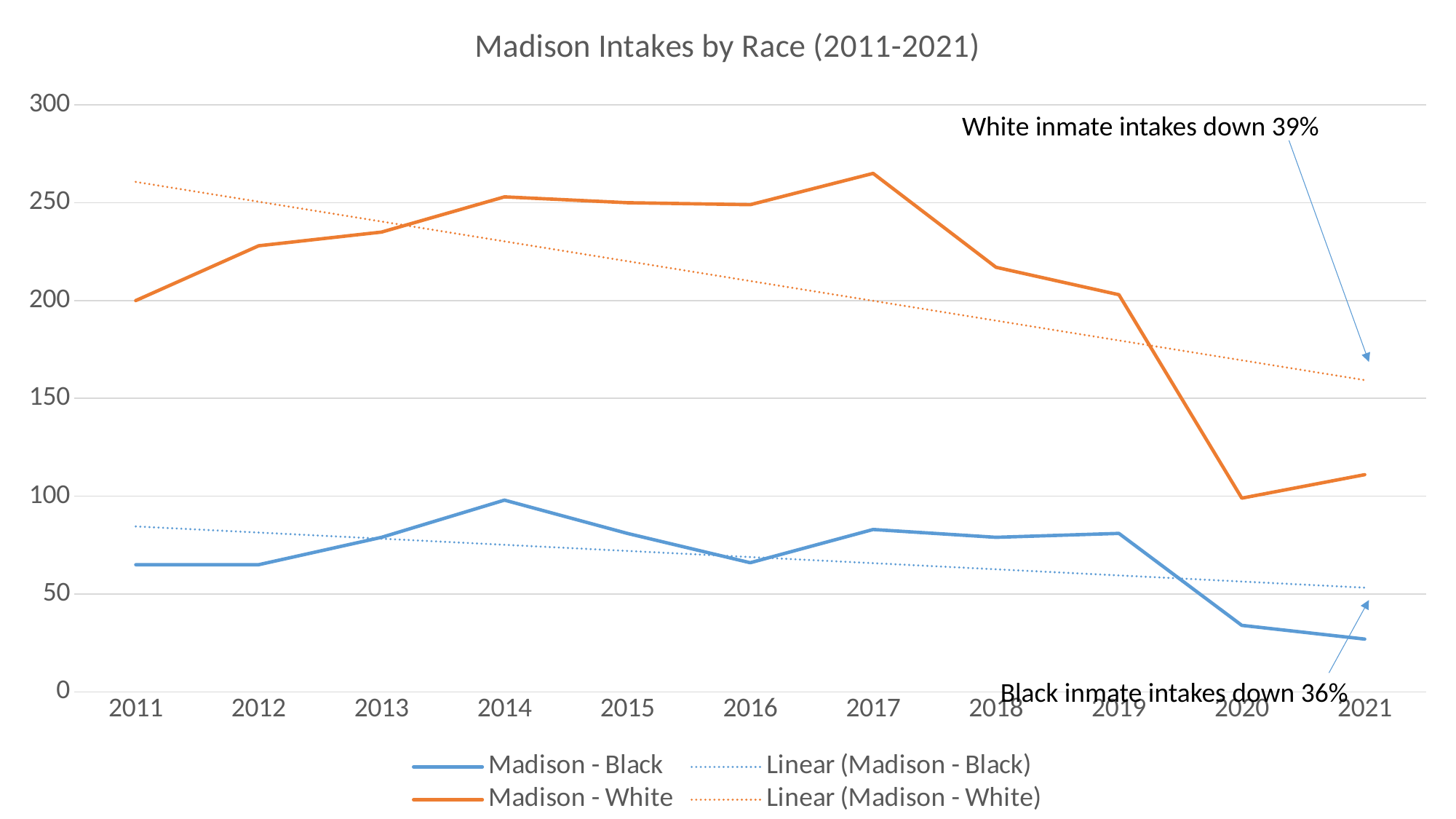
Does the Madison - White series rise or fall from 2017 to 2020? fall In which year is the Madison - White series at its highest? 2017 What kind of chart is shown on the slide? line chart In which year is the Madison - White series at its lowest? 2020 Is the value for Madison - Black in 2020 greater or less than 50? less How many years are plotted along the x axis? 11 In which year is the Madison - Black series at its lowest? 2021 What is the title of the chart? Madison Intakes by Race (2011-2021) In which year is the Madison - Black series at its highest? 2014 Is the value for Madison - White in 2021 greater or less than 100? greater How many entries does the legend list? 4 In 2017, which series has the larger value, Madison - White or Madison - Black? Madison - White